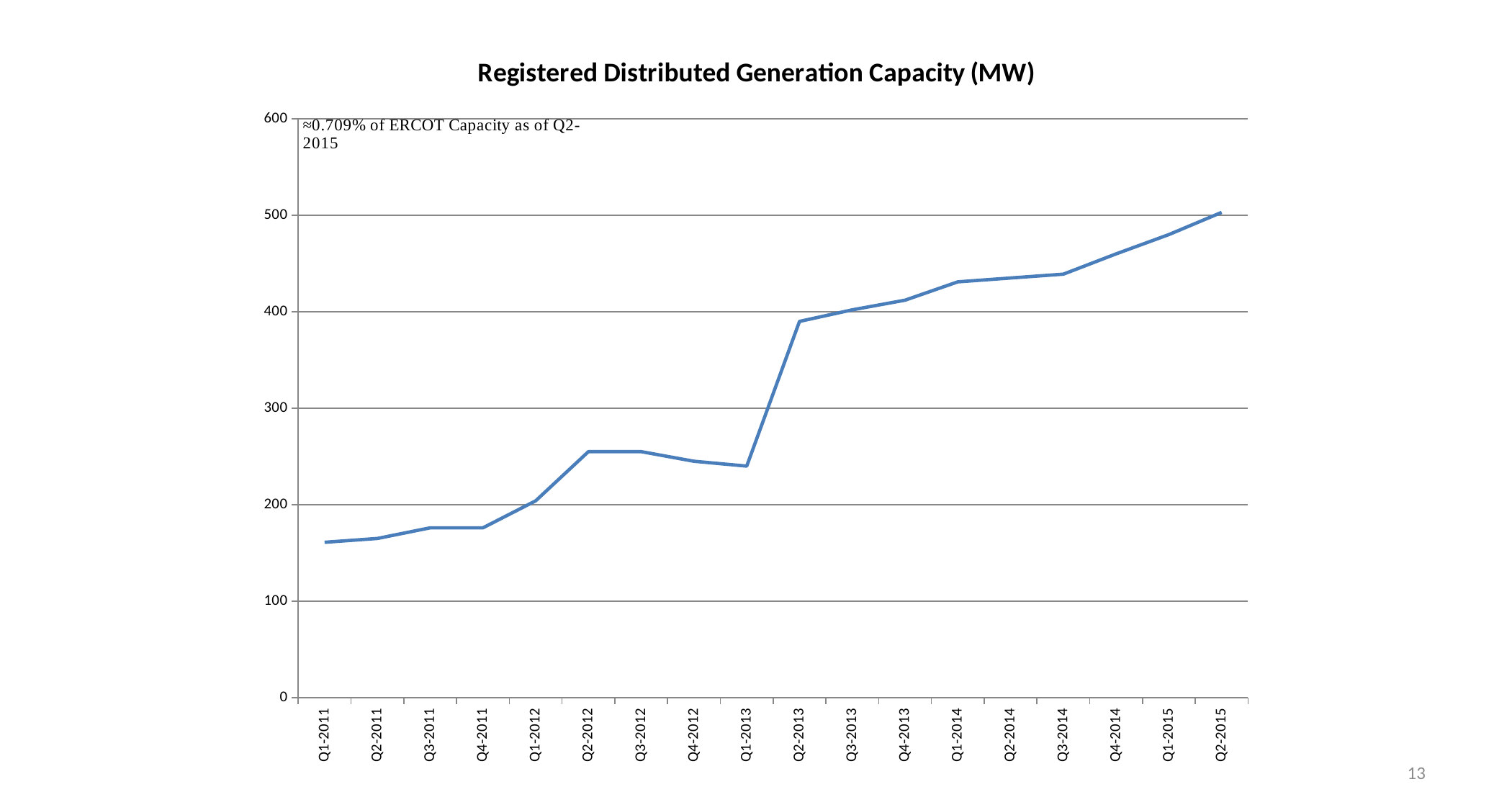
How many quarters are plotted along the x axis? 18 Overall, do the values rise or fall from Q1-2011 to Q2-2015? Rise What is the title of the chart? Registered Distributed Generation Capacity (MW) Is the value for Q2-2013 greater or less than 300? greater Which quarter has the highest registered distributed generation capacity? Q2-2015 According to the annotation on the chart, what share of ERCOT capacity does the registered distributed generation represent as of Q2-2015? ≈0.709% Is the value for Q1-2011 greater or less than 200? less Is the value for Q1-2013 greater or less than 300? less Which is larger, the value for Q1-2013 or the value for Q2-2013? Q2-2013 What kind of chart is shown on the slide? Line chart